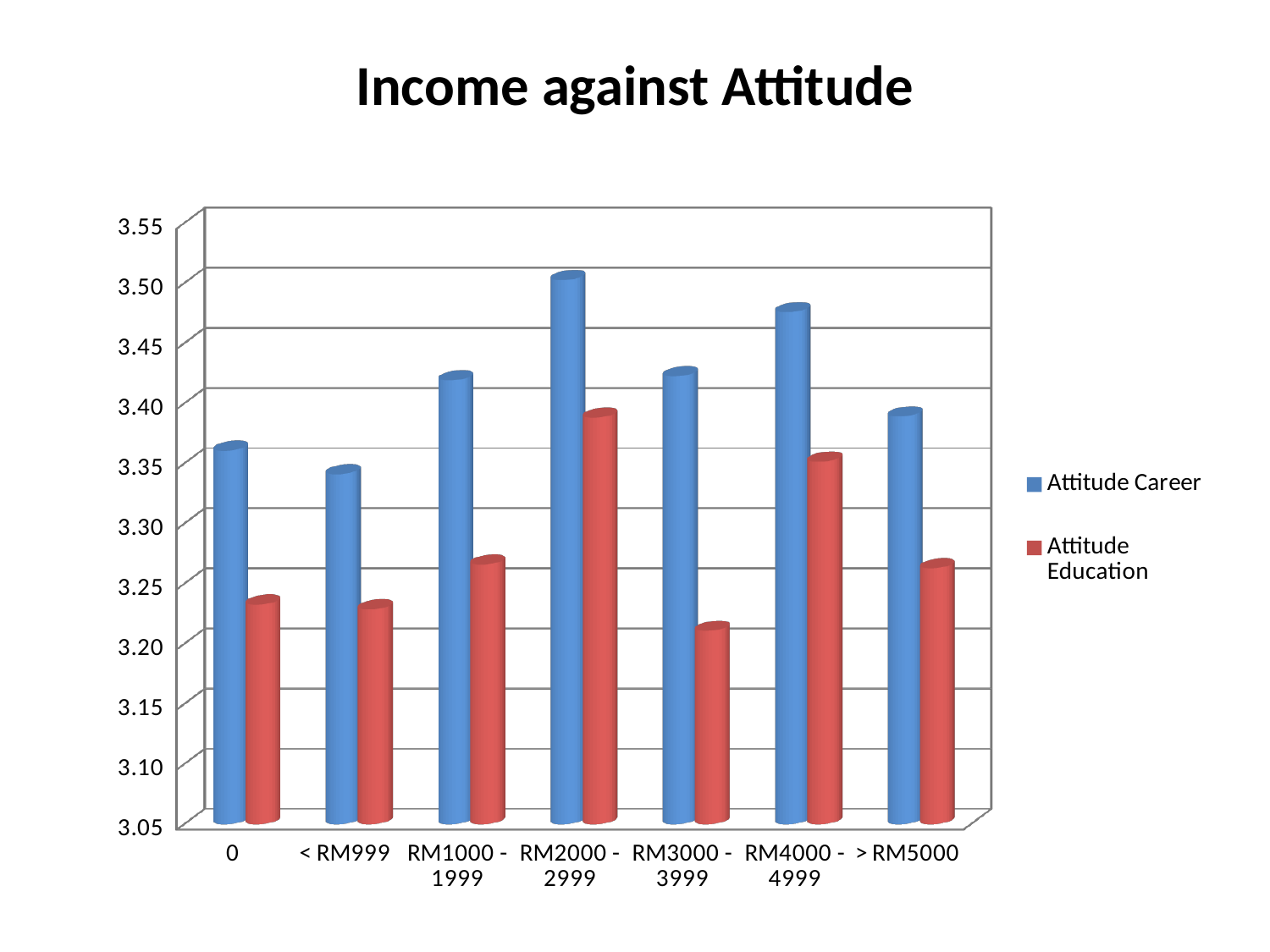
What kind of chart is shown on the slide? bar chart What is the title of the chart? Income against Attitude How many series does the legend list? 2 Which series is shown in blue? Attitude Career For RM1000 - 1999, which is larger: Attitude Career or Attitude Education? Attitude Career Is the Attitude Career value for RM4000 - 4999 greater or less than 3.40? greater Which income category has the highest Attitude Education value? RM2000 - 2999 Which income category has the highest Attitude Career value? RM2000 - 2999 Is the Attitude Education value for RM3000 - 3999 greater or less than 3.25? less How many income categories are shown on the x axis? 7 Is the Attitude Career value for RM2000 - 2999 greater or less than 3.45? greater